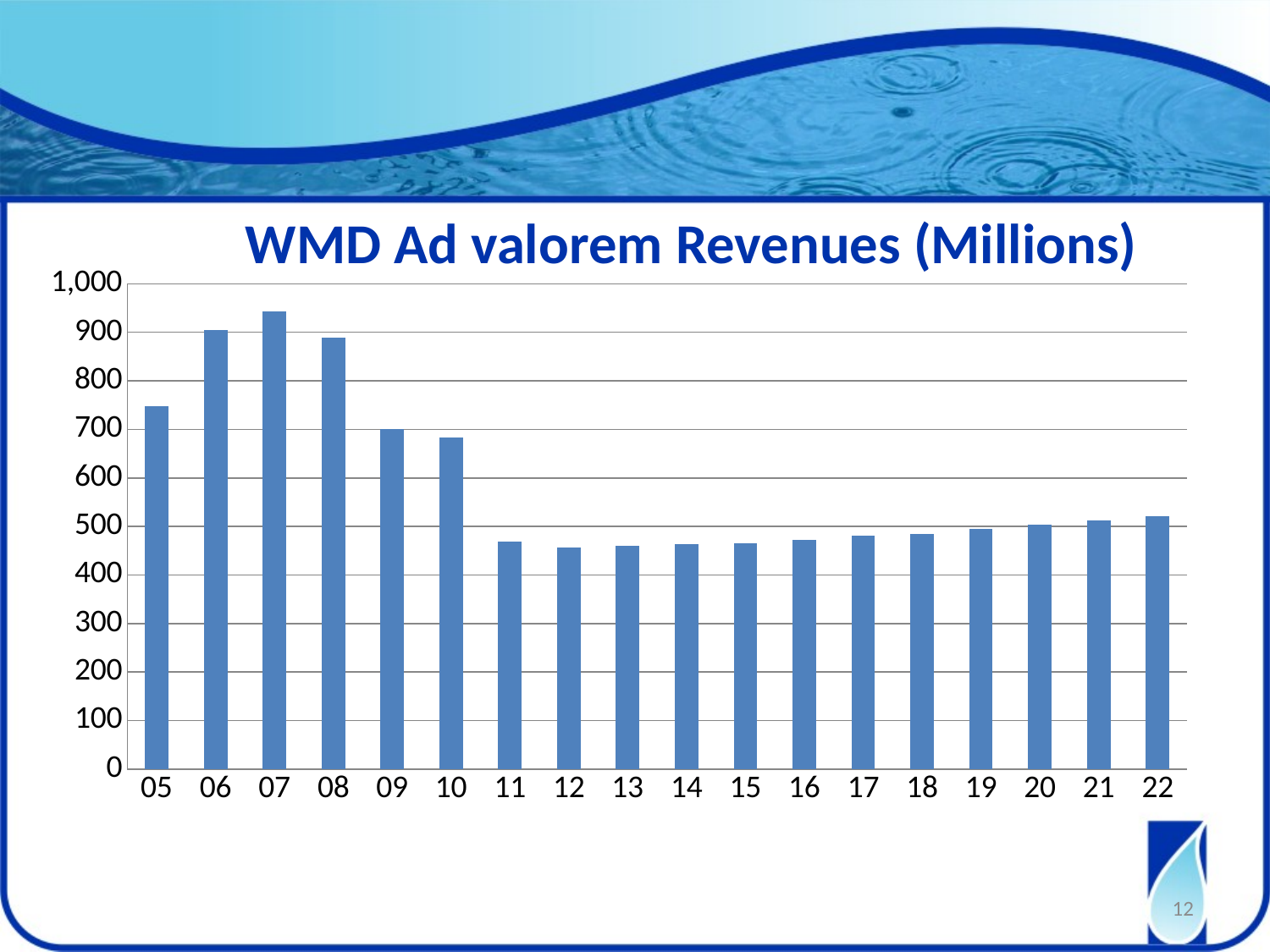
Is the value for 11 greater or less than 500? less Is the value for 05 greater or less than 700? greater Which is larger, the value for 05 or the value for 09? 05 Is the value for 22 greater or less than 500? greater Which year has the highest revenue? 07 What type of chart is shown on the slide? bar chart What is the title of the chart? WMD Ad valorem Revenues (Millions) Which is larger, the value for 11 or the value for 22? 22 How many years (bars) are shown on the x axis? 18 Do the values rise or fall from 12 to 22? rise